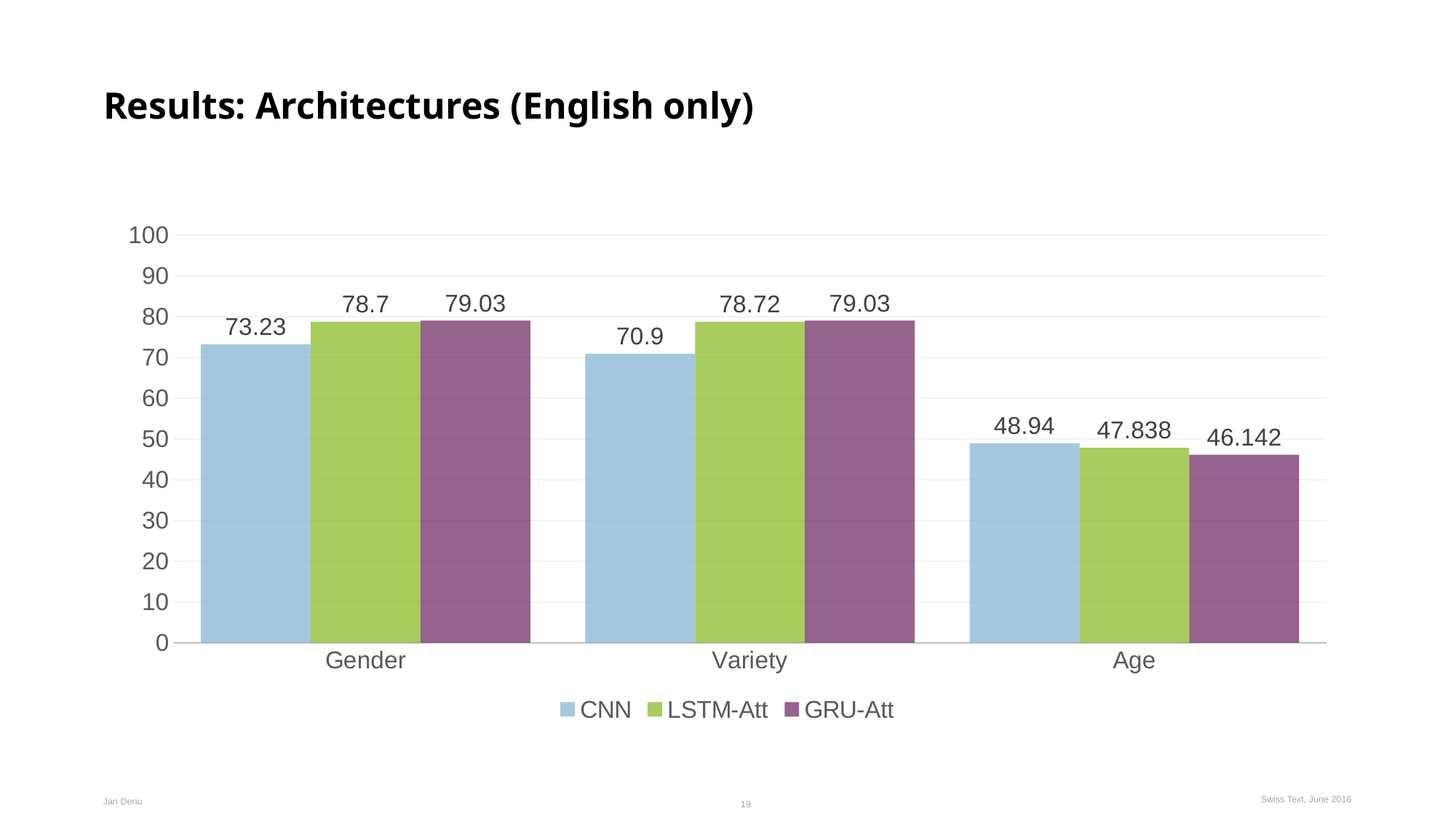
Which category has the lowest value for CNN? Age Which series has the highest value in the Age category? CNN How many series does the legend list? 3 How many categories are shown on the x axis? 3 What is the difference between the GRU-Att and CNN values in the Gender category? 5.8 What is the title of the slide? Results: Architectures (English only) What is the value for LSTM-Att in the Variety category? 78.72 Is the value for LSTM-Att in the Age category greater or less than 50? less What is the value for CNN in the Gender category? 73.23 What is the value for GRU-Att in the Age category? 46.142 Which is larger in the Variety category: CNN or GRU-Att? GRU-Att What kind of chart is shown on the slide? bar chart